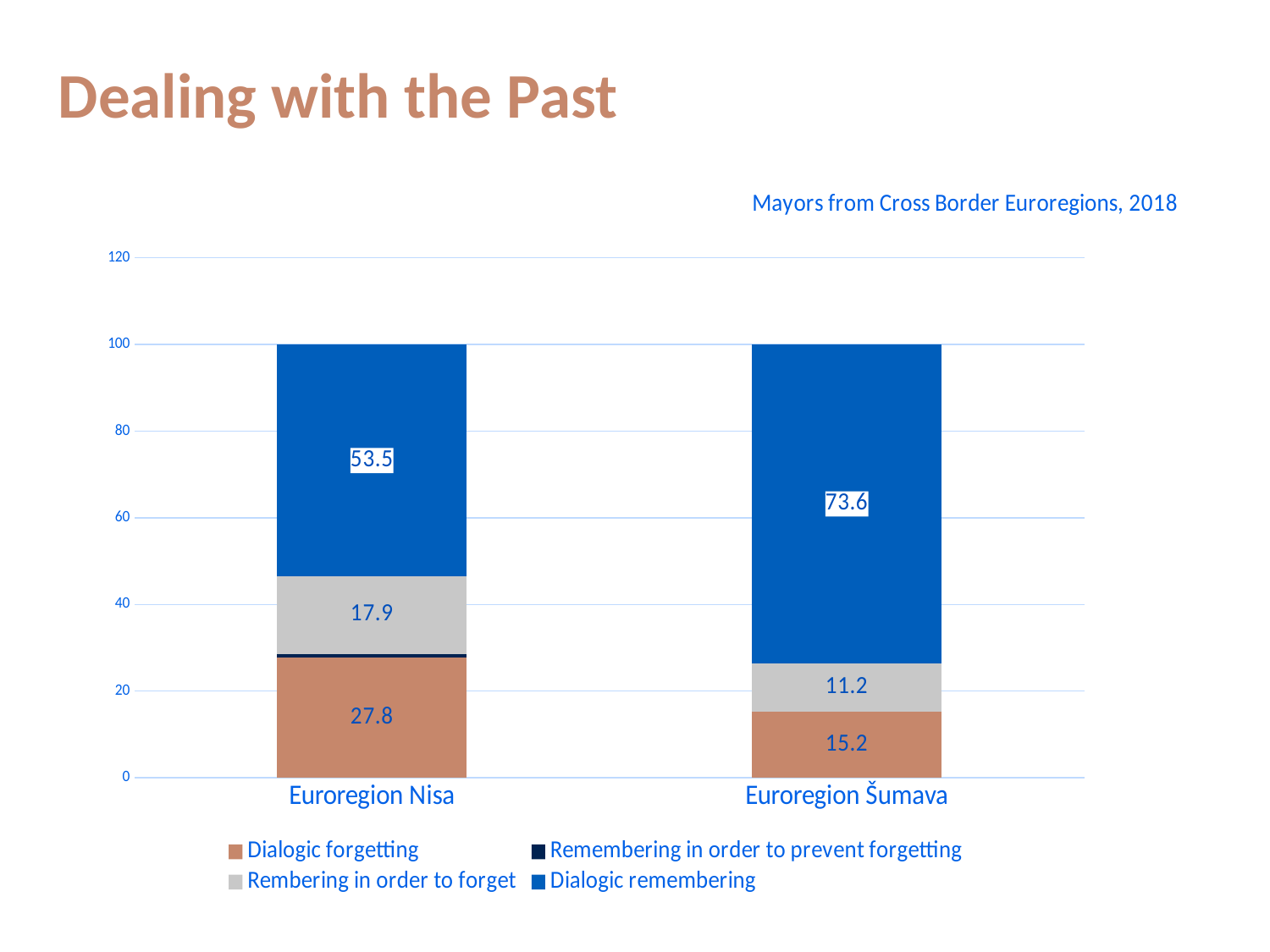
Which euroregion has the larger value for Dialogic forgetting? Euroregion Nisa What kind of chart is shown on the slide? Stacked bar chart Is the total height of the Euroregion Nisa stacked bar greater or less than 80? greater What is the value for Dialogic forgetting in Euroregion Šumava? 15.2 What is the value for Dialogic remembering in Euroregion Nisa? 53.5 What is the value for Dialogic remembering in Euroregion Šumava? 73.6 What is the value for Rembering in order to forget in Euroregion Nisa? 17.9 What is the difference between the Dialogic forgetting values for Euroregion Nisa and Euroregion Šumava? 12.6 What is the difference between the Dialogic remembering values for Euroregion Šumava and Euroregion Nisa? 20.1 How many series does the legend list? 4 How many euroregions are shown on the x axis? 2 Which series has the largest value for Euroregion Šumava? Dialogic remembering